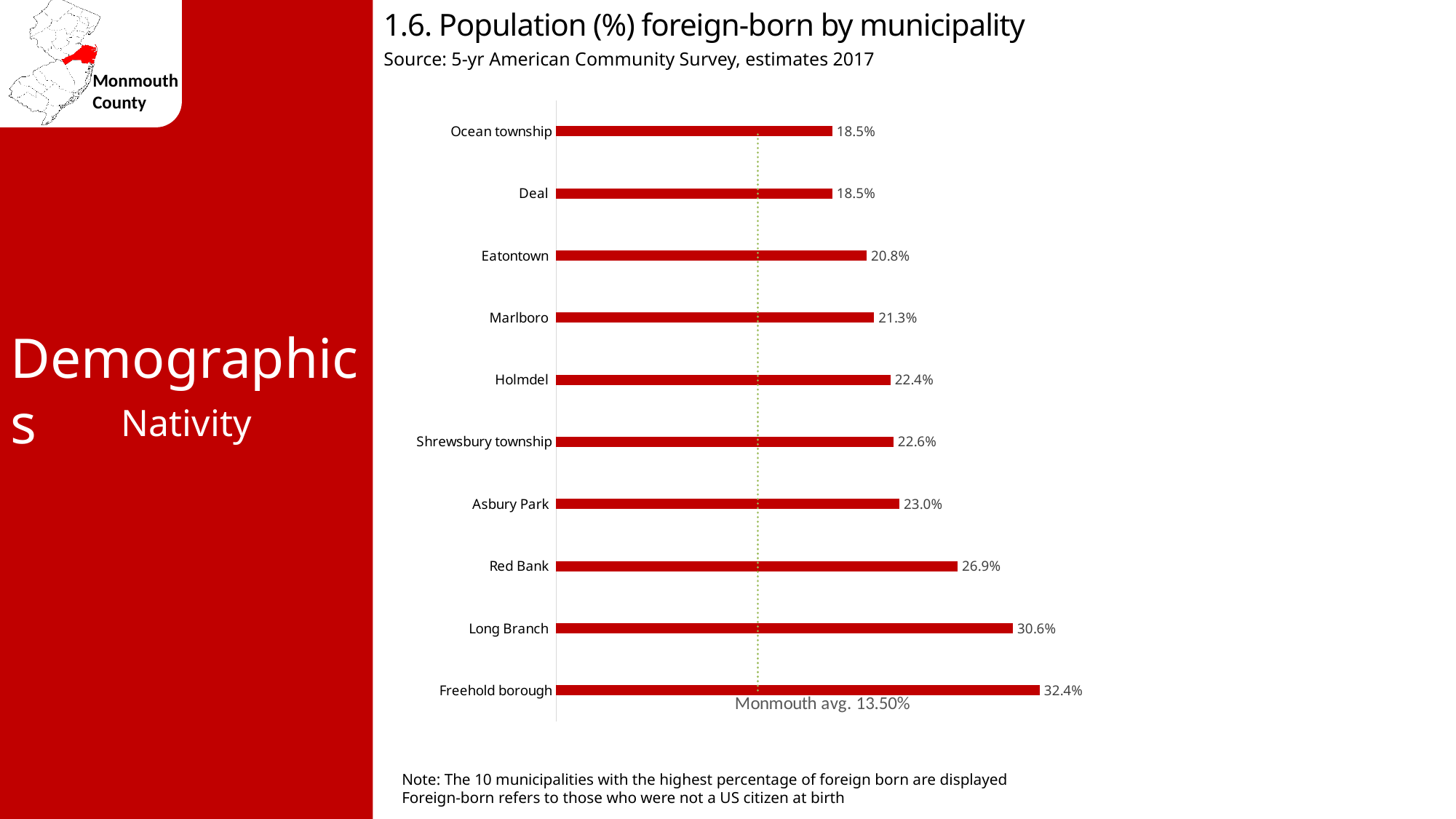
Which has a higher foreign-born percentage, Red Bank or Shrewsbury township? Red Bank What is the source of the data shown in the chart? 5-yr American Community Survey, estimates 2017 What type of chart is used on this slide? Bar chart Which municipality has the lowest value shown on the chart, Eatontown or Marlboro? Eatontown What is the Monmouth County average foreign-born percentage marked by the dotted line? 13.50% Which municipality has the highest percentage of foreign-born population? Freehold borough How many municipalities are shown on the chart? 10 What is the foreign-born population percentage for Holmdel? 22.4% What is the difference in foreign-born percentage between Asbury Park and Ocean township? 4.5% What is the foreign-born population percentage for Freehold borough? 32.4% What is the difference in foreign-born percentage between Freehold borough and Long Branch? 1.8% What is the foreign-born population percentage for Red Bank? 26.9%